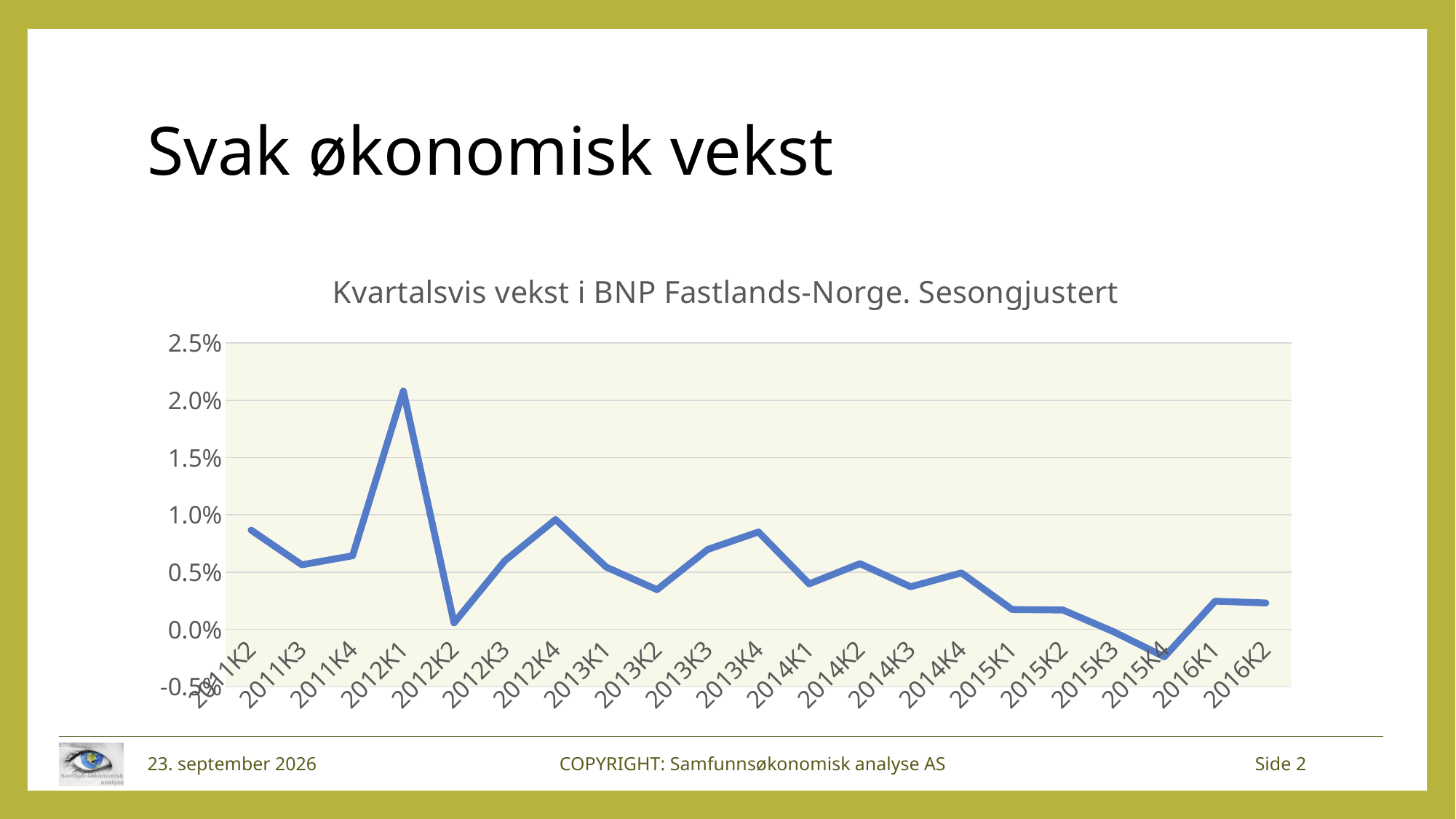
Which is larger, the value for 2013K4 or the value for 2014K1? 2013K4 Is the value for 2012K1 greater or less than 1.5%? greater What is the title of the chart? Kvartalsvis vekst i BNP Fastlands-Norge. Sesongjustert Is the value for 2012K2 greater or less than 0.5%? less Do the values generally rise or fall from 2013K4 to 2015K4? fall What kind of chart is shown on the slide? line chart Which quarter has the highest growth value? 2012K1 Is the value for 2015K4 greater or less than 0.0%? less Which quarter has the lowest growth value? 2015K4 Which is larger, the value for 2011K2 or the value for 2011K3? 2011K2 How many quarters are plotted on the x axis? 21